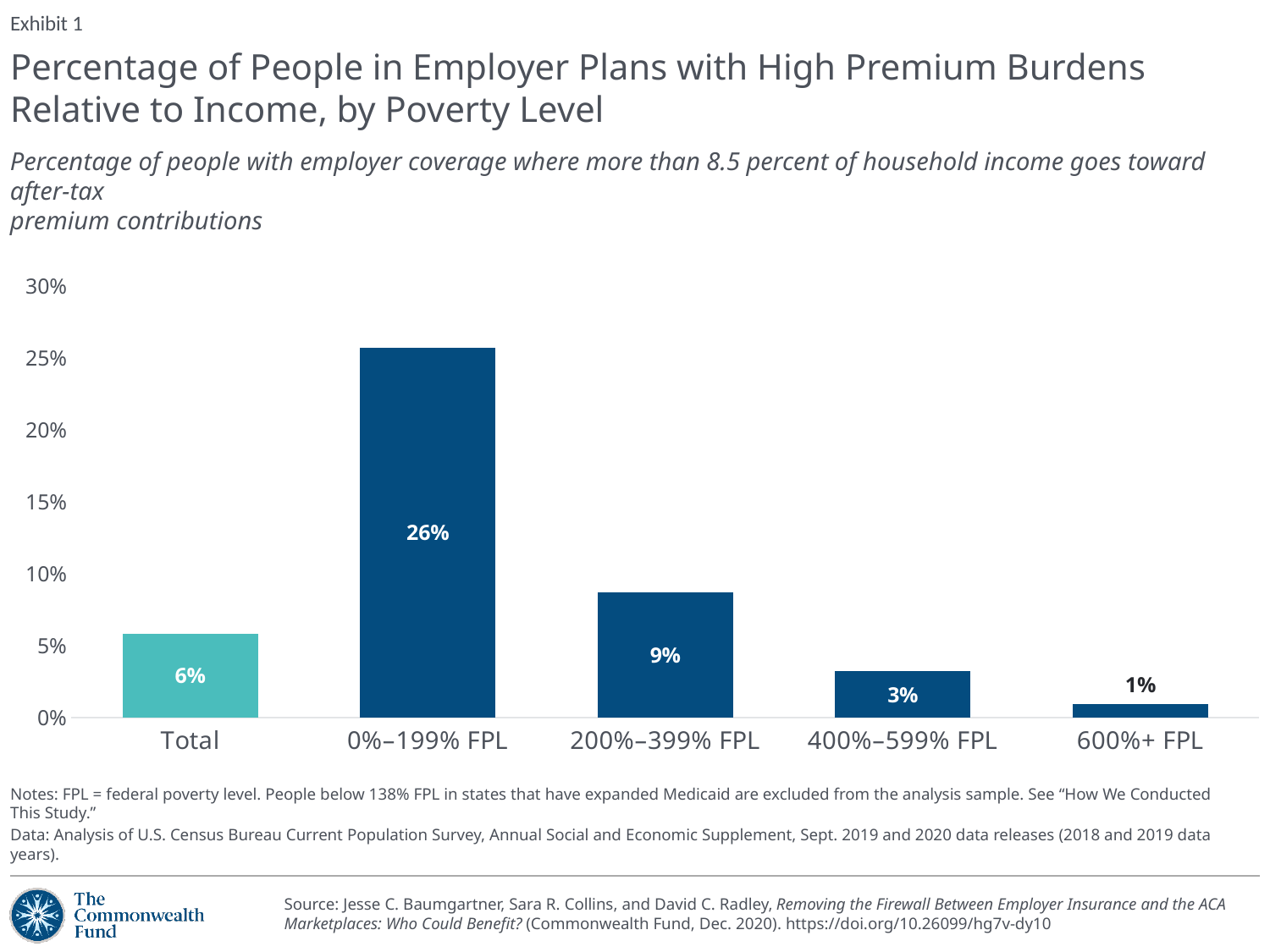
How many categories are shown on the x axis? 5 What kind of chart is shown on the slide? Bar chart What is the value for the 0%–199% FPL category? 26% What is the difference between the values for 0%–199% FPL and 200%–399% FPL? 17% Which category has the lowest value? 600%+ FPL What is the value for the Total bar? 6% Which is larger, the value for 200%–399% FPL or the value for Total? 200%–399% FPL Is the value for 0%–199% FPL greater or less than 20%? greater Do the values rise or fall across the FPL categories from 0%–199% FPL to 600%+ FPL? Fall Which bar is shown in a different colour from the others? Total What is the value for the 400%–599% FPL category? 3% Which category has the highest value? 0%–199% FPL